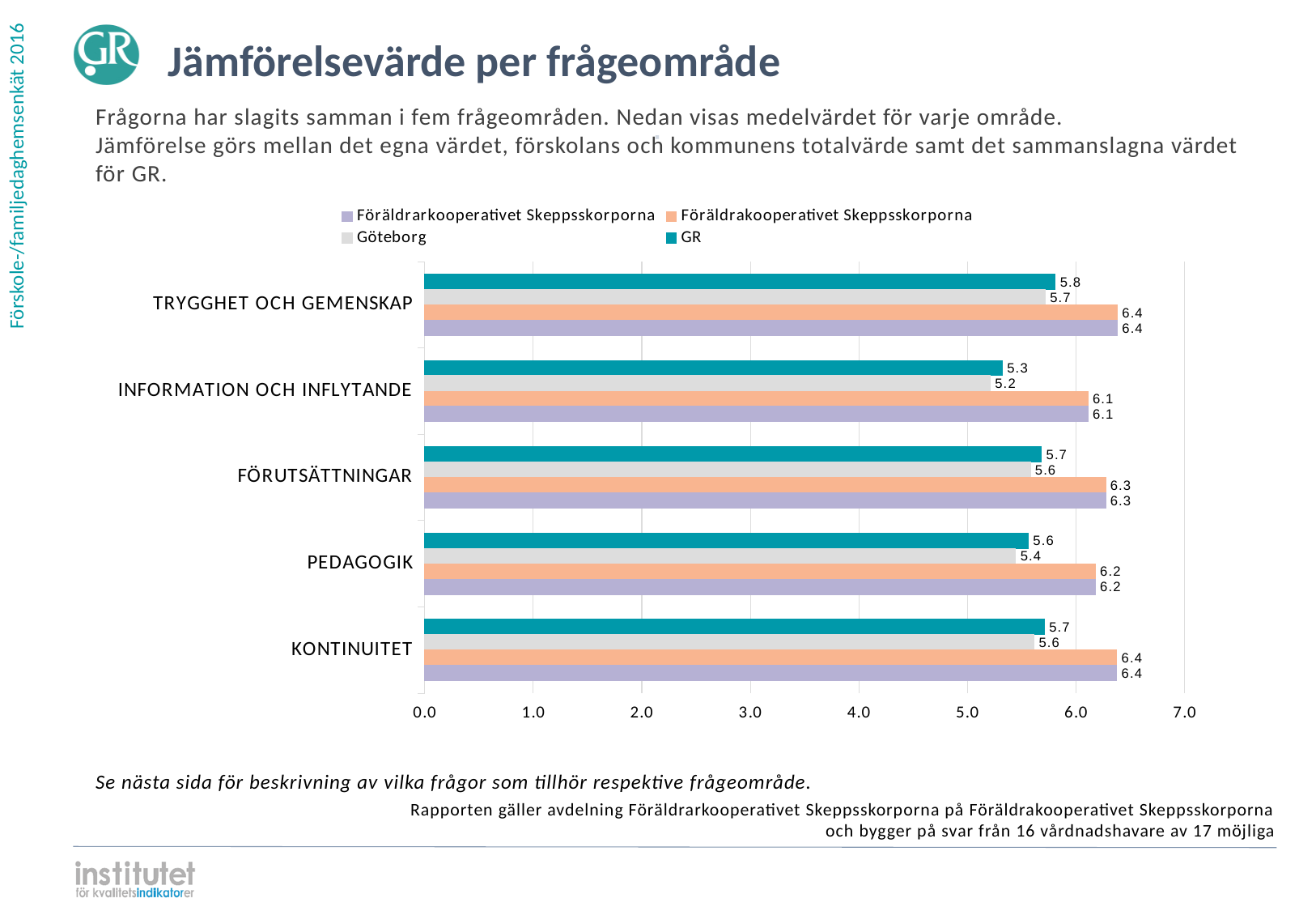
What is the GR value for TRYGGHET OCH GEMENSKAP? 5.8 What is the Göteborg value for PEDAGOGIK? 5.4 Which is larger for FÖRUTSÄTTNINGAR: the GR value or the Göteborg value? GR What is the title of the slide containing the chart? Jämförelsevärde per frågeområde What is the difference between the GR value and the Göteborg value for PEDAGOGIK? 0.2 What is the Göteborg value for KONTINUITET? 5.6 What kind of chart is shown on the slide? Bar chart What is the GR value for INFORMATION OCH INFLYTANDE? 5.3 How many categories (question areas) are shown on the chart? 5 Which category has the highest GR value? TRYGGHET OCH GEMENSKAP Which category has the lowest GR value? INFORMATION OCH INFLYTANDE How many series does the legend list? 4